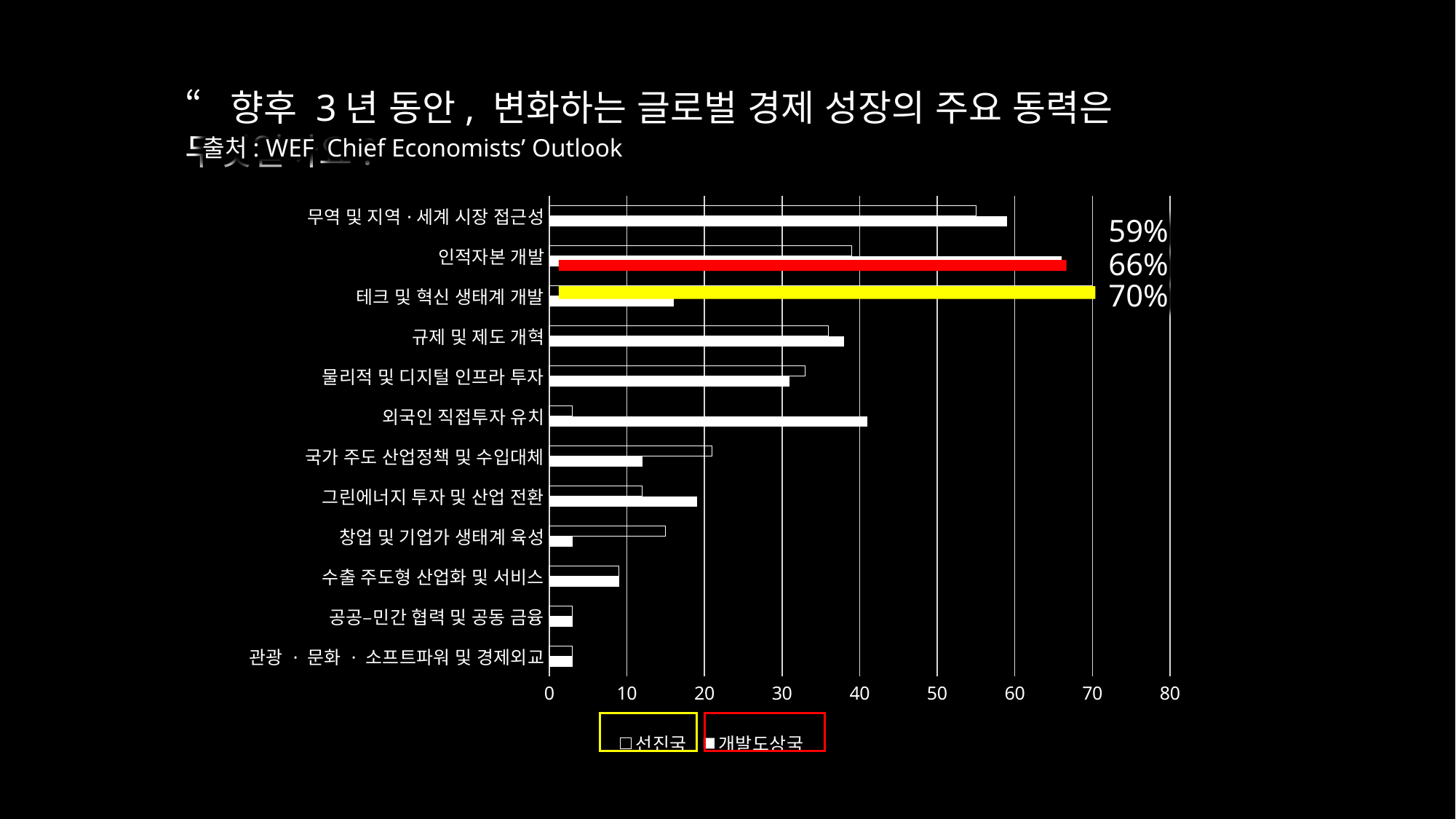
In the 외국인 직접투자 유치 category, which series has the larger value, 선진국 or 개발도상국? 개발도상국 Is the 개발도상국 value for 외국인 직접투자 유치 greater or less than 30? greater Is the 선진국 value for 규제 및 제도 개혁 greater or less than 40? less In the 창업 및 기업가 생태계 육성 category, which series has the larger value, 선진국 or 개발도상국? 선진국 What is the value for 선진국 in the 테크 및 혁신 생태계 개발 category? 70% How many series does the legend list? 2 Which category has the highest 선진국 value? 테크 및 혁신 생태계 개발 How many categories are plotted on the chart? 12 What is the value for 개발도상국 in the 인적자본 개발 category? 66% What are the two series named in the legend? 선진국 and 개발도상국 Which category has the highest 개발도상국 value? 인적자본 개발 What type of chart is shown on the slide? Bar chart